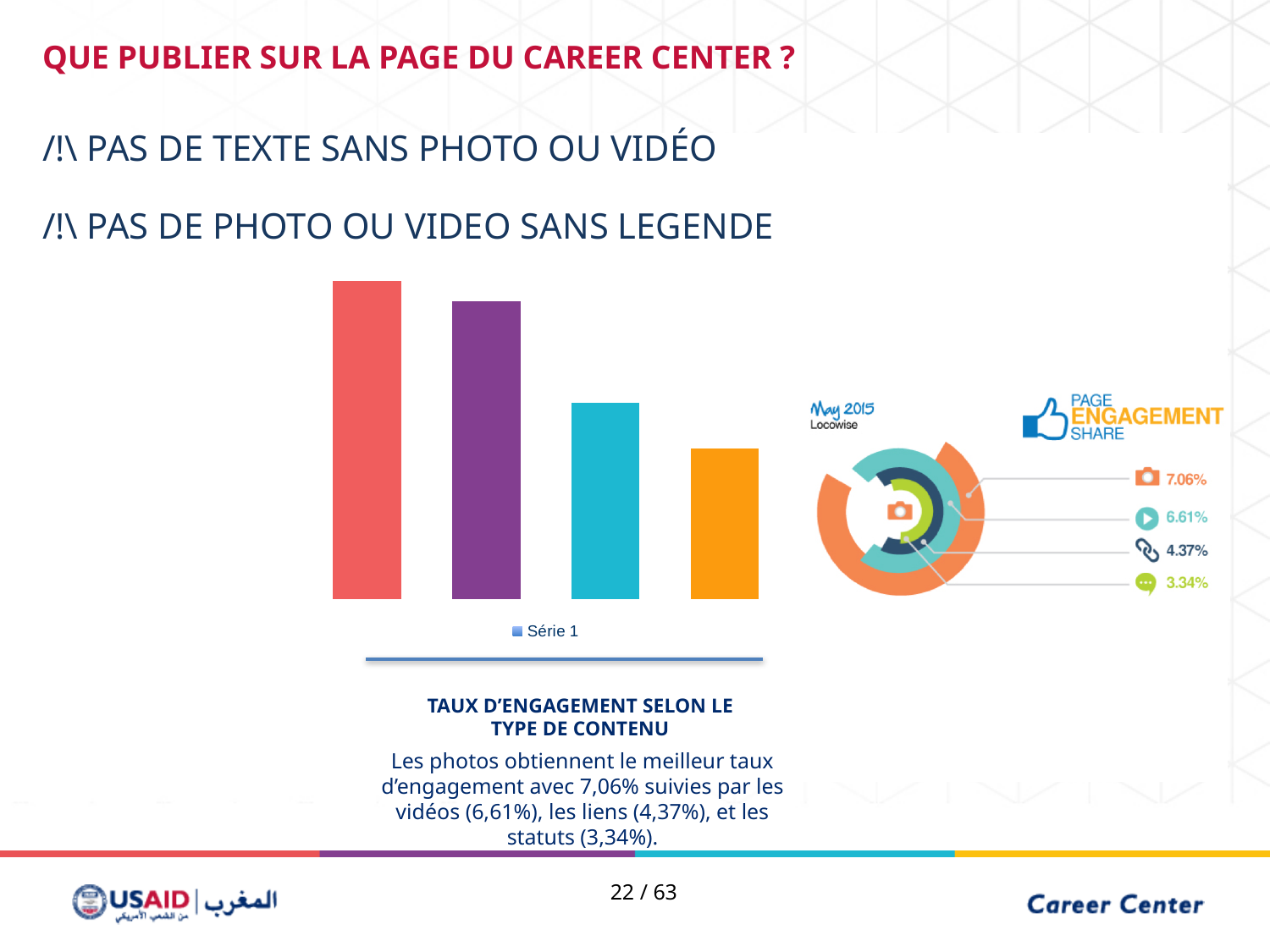
How many values are listed next to the 'Page Engagement Share' donut chart on the right? 4 In the bar chart on the left, which bar is the tallest: the first (red) or the fourth (orange)? the first (red) How many bars does the bar chart on the left have? 4 In the 'Page Engagement Share' donut chart on the right, what is the highest value shown? 7.06% What is the legend entry of the bar chart on the left? Série 1 What kind of chart is the chart on the left with the legend 'Série 1'? bar chart In the bar chart on the left, what colour is the second bar? purple In the 'Page Engagement Share' donut chart on the right, what is the difference between the highest value (7.06%) and the lowest value (3.34%)? 3.72% In the bar chart on the left, do the bar heights rise or fall from left to right? fall In the 'Page Engagement Share' donut chart on the right, what is the lowest value shown? 3.34% How many series does the legend of the bar chart on the left list? 1 In the bar chart on the left, which bar is the shortest? the fourth (orange) bar